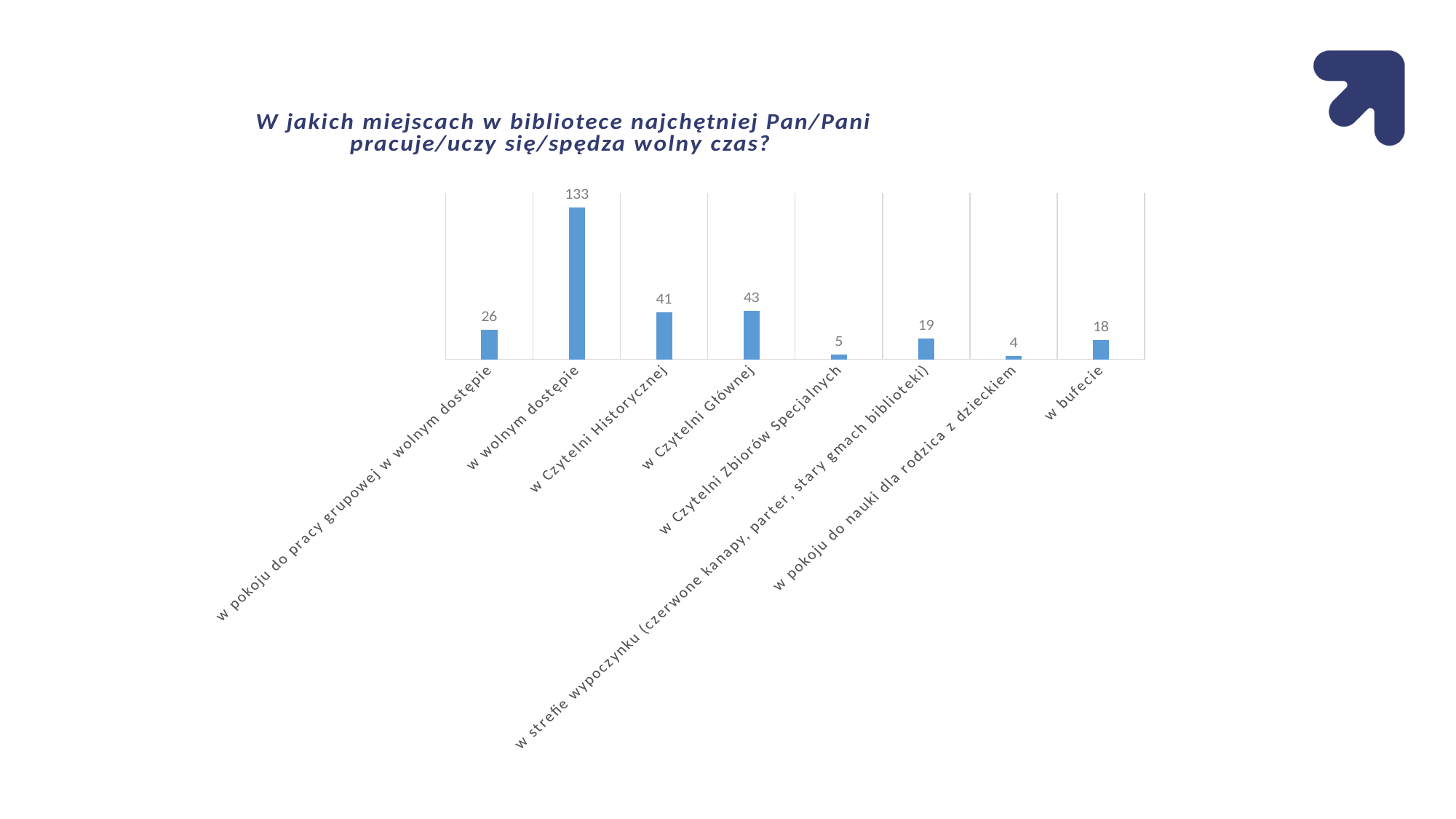
What is the difference between the values for "w wolnym dostępie" and "w Czytelni Głównej"? 90 What is the title of the chart? W jakich miejscach w bibliotece najchętniej Pan/Pani pracuje/uczy się/spędza wolny czas? How many categories are shown on the chart? 8 Which category has the highest value? w wolnym dostępie What is the value for "w bufecie"? 18 What is the value for "w wolnym dostępie"? 133 What is the value for "w pokoju do pracy grupowej w wolnym dostępie"? 26 What is the value for "w Czytelni Głównej"? 43 Which category has the lowest value? w pokoju do nauki dla rodzica z dzieckiem What is the difference between the values for "w Czytelni Historycznej" and "w Czytelni Zbiorów Specjalnych"? 36 Which is larger, the value for "w pokoju do pracy grupowej w wolnym dostępie" or the value for "w bufecie"? w pokoju do pracy grupowej w wolnym dostępie What kind of chart is shown on the slide? bar chart